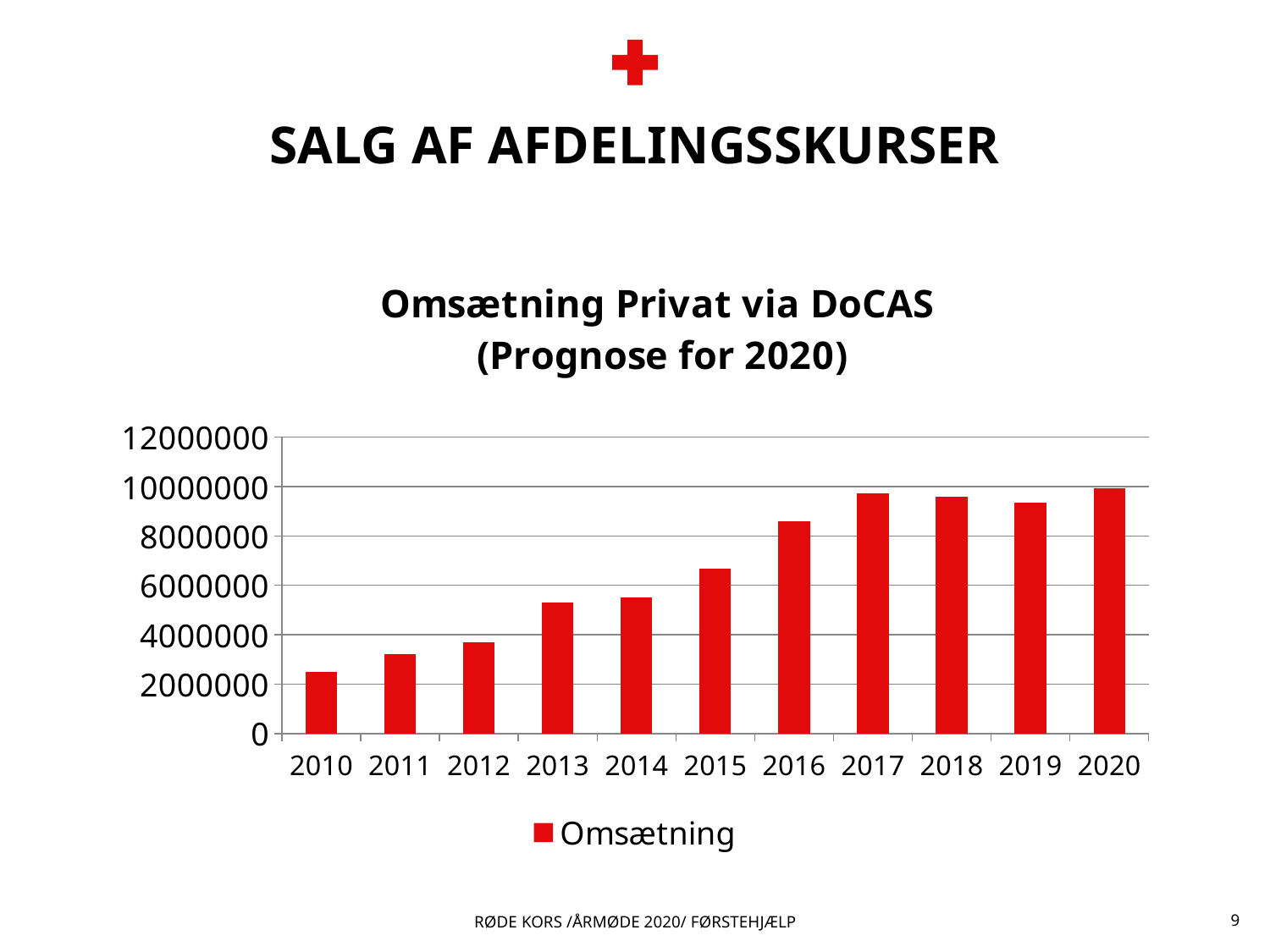
What is the name of the series shown in the legend? Omsætning Is the value for 2010 greater or less than 2000000? greater Is the value for 2013 greater or less than 6000000? less How many series does the chart's legend list? 1 Which year has the larger value, 2015 or 2016? 2016 Is the value for 2019 greater or less than 10000000? less What kind of chart is shown on the slide? Bar chart Do the values generally rise or fall from 2010 to 2020? Rise How many years are shown on the x axis of the chart? 11 What is the title of the chart? Omsætning Privat via DoCAS (Prognose for 2020) Which year has the lowest value in the chart? 2010